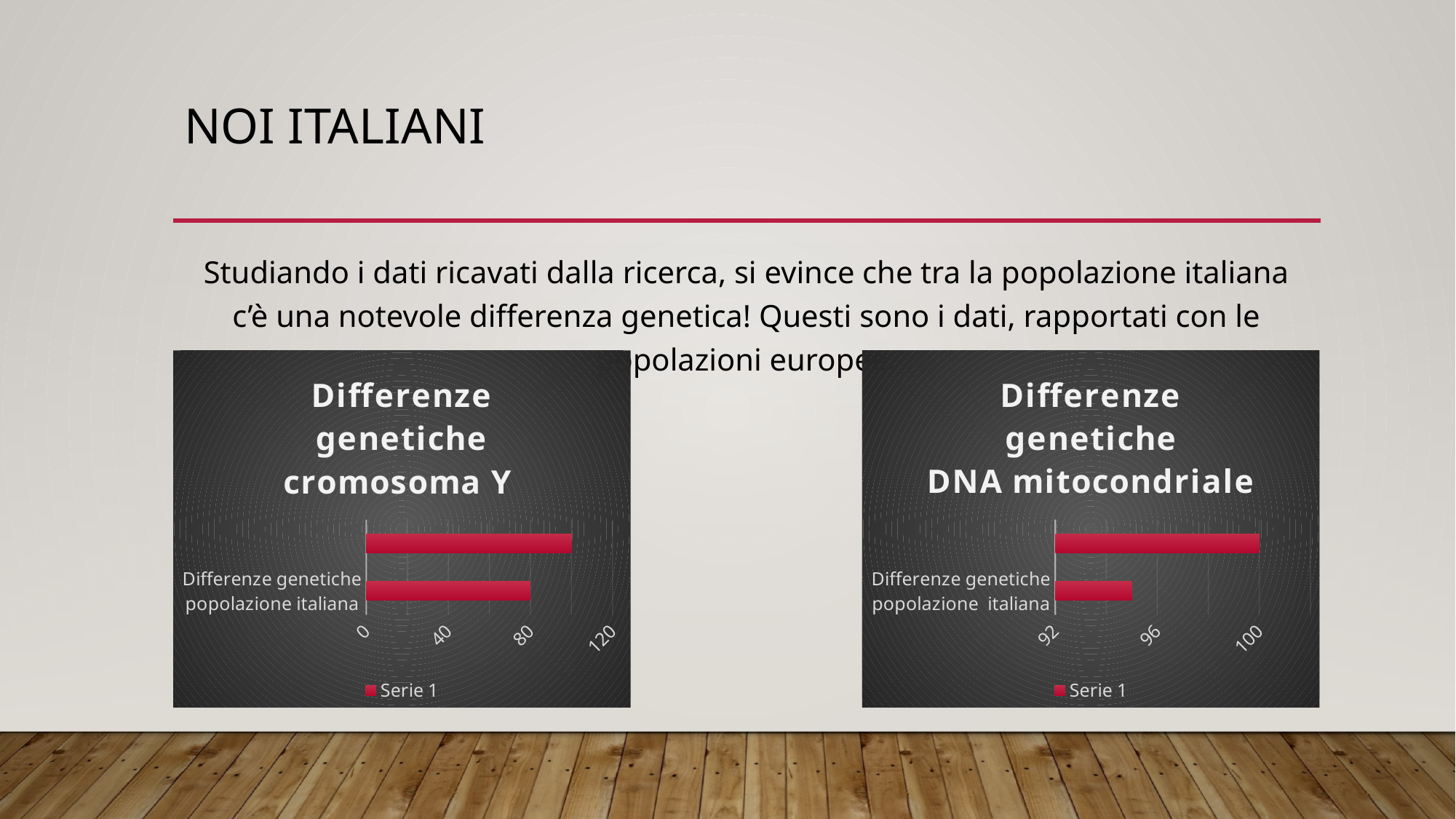
What kind of chart is the 'Differenze genetiche cromosoma Y' chart on the left? bar chart In the right chart ('Differenze genetiche DNA mitocondriale'), is the bar for 'Differenze genetiche popolazione italiana' longer or shorter than the bar above it? shorter In the left chart ('Differenze genetiche cromosoma Y'), is the value of the top bar greater or less than 80? greater In the left chart ('Differenze genetiche cromosoma Y'), is the value for 'Differenze genetiche popolazione italiana' greater or less than 40? greater How many series does the legend of the left chart ('Differenze genetiche cromosoma Y') list? 1 What is the legend entry shown on the right chart ('Differenze genetiche DNA mitocondriale')? Serie 1 What kind of chart is the 'Differenze genetiche DNA mitocondriale' chart on the right? bar chart How many bars are plotted in the right chart ('Differenze genetiche DNA mitocondriale')? 2 What is the title of the chart on the left of the slide? Differenze genetiche cromosoma Y In the right chart ('Differenze genetiche DNA mitocondriale'), is the value of the top bar greater or less than 96? greater How many bars are plotted in the left chart ('Differenze genetiche cromosoma Y')? 2